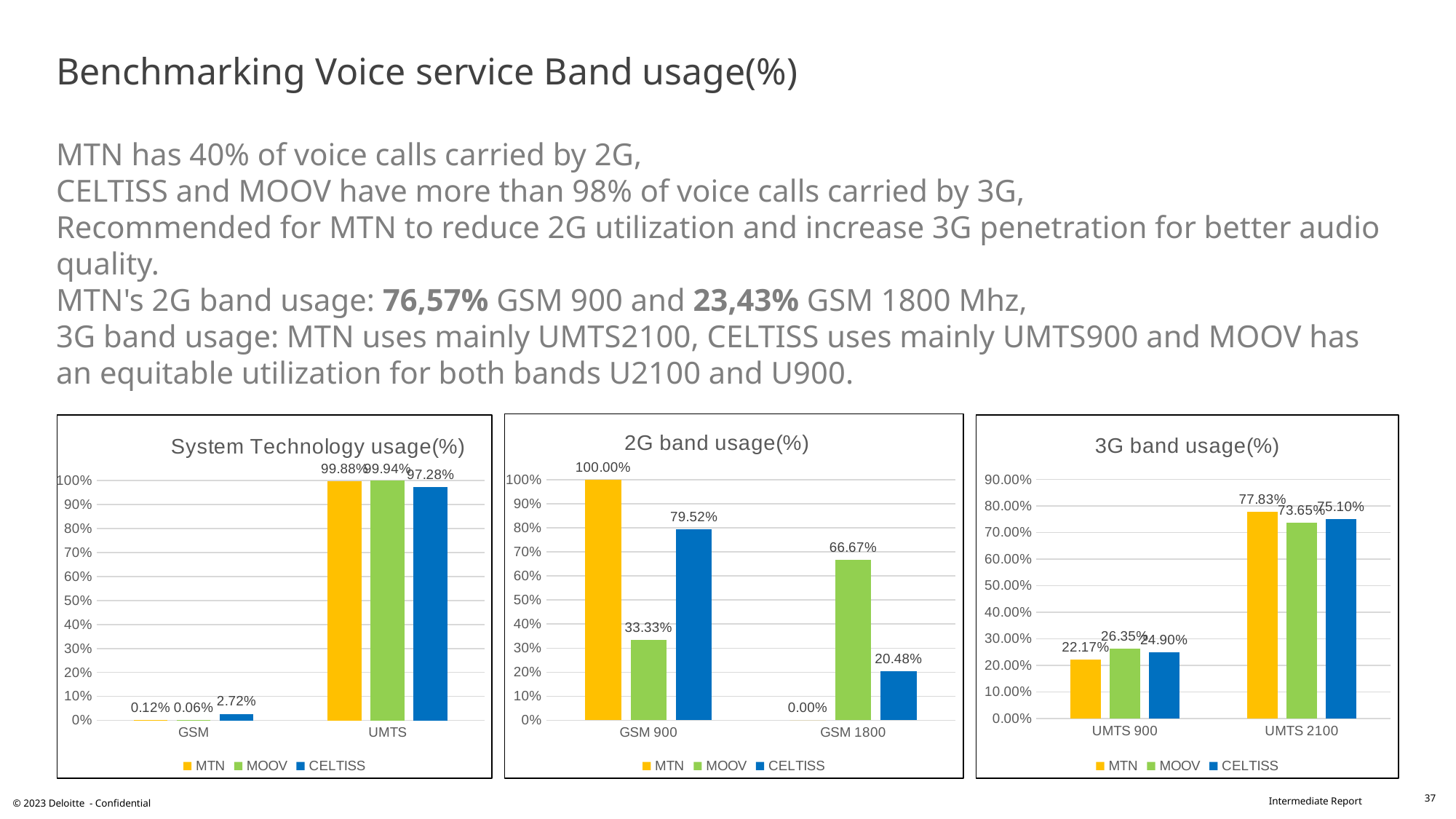
In the "2G band usage(%)" chart, is the value for CELTISS at GSM 1800 greater or less than 30%? less In the "2G band usage(%)" chart, which operator has the highest value at GSM 900? MTN What kind of chart is the "2G band usage(%)" chart? Bar chart In the "3G band usage(%)" chart, which operator has the lowest value at UMTS 900? MTN In the "3G band usage(%)" chart, what is the value for MTN at UMTS 2100? 77.83% In the "System Technology usage(%)" chart, what is the value for CELTISS at GSM? 2.72% In the "2G band usage(%)" chart, what is the value for CELTISS at GSM 900? 79.52% How many charts are shown on the slide? 3 In the "System Technology usage(%)" chart, which is larger at UMTS: MOOV or CELTISS? MOOV In the "2G band usage(%)" chart, what is the value for MOOV at GSM 1800? 66.67% In the "2G band usage(%)" chart, what is the difference between MOOV's values at GSM 1800 and GSM 900? 33.34% How many series does the legend of the "3G band usage(%)" chart list? 3